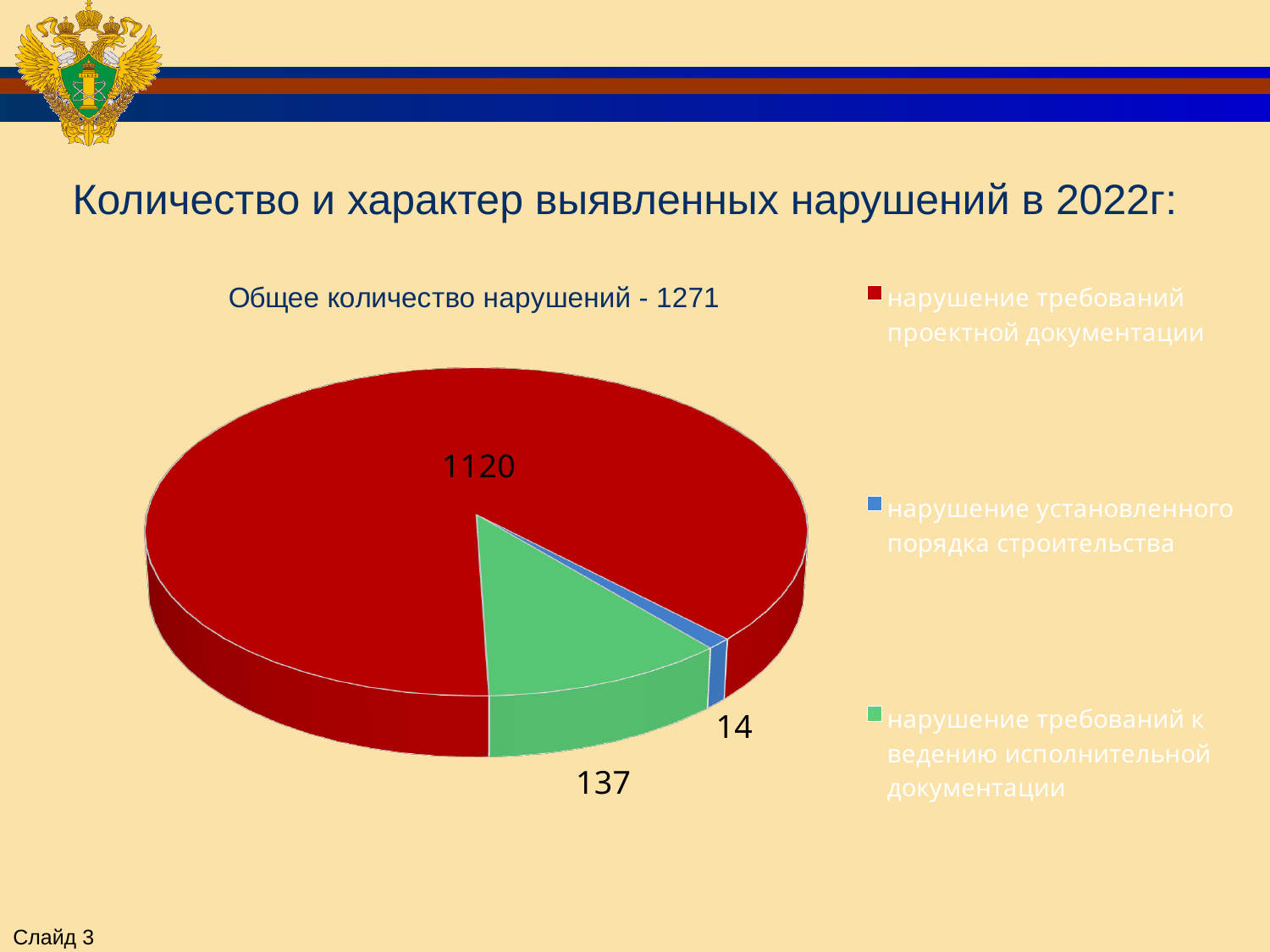
What is the difference between the values for 'нарушение требований проектной документации' and 'нарушение требований к ведению исполнительной документации'? 983 Which category has the smallest slice of the pie? нарушение установленного порядка строительства Which is larger: the value for 'нарушение требований к ведению исполнительной документации' or for 'нарушение установленного порядка строительства'? нарушение требований к ведению исполнительной документации What is the value for 'нарушение установленного порядка строительства'? 14 What kind of chart is shown on the slide? pie chart What is the total of all slices in the pie chart? 1271 What share of the pie does 'нарушение требований к ведению исполнительной документации' represent, to the nearest whole percent? 11% Which category has the largest slice of the pie? нарушение требований проектной документации How many slices does the pie chart have? 3 What colour is the slice for 'нарушение установленного порядка строительства'? blue What is the value for 'нарушение требований к ведению исполнительной документации'? 137 What is the value for 'нарушение требований проектной документации'? 1120